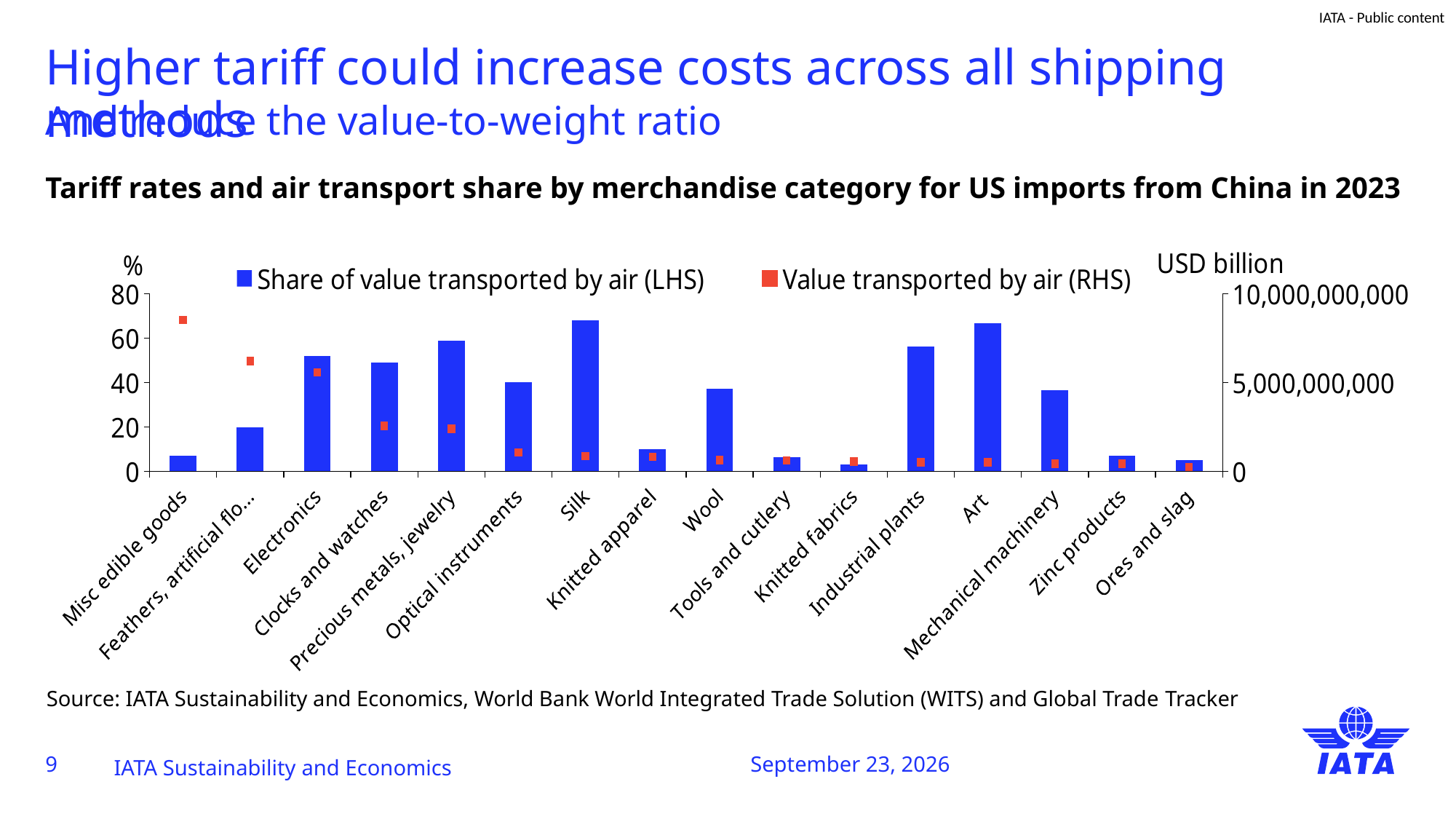
Is the value transported by air (red marker) for Misc edible goods greater or less than 5,000,000,000 on the right-hand axis? greater Which has a larger share of value transported by air, Art or Mechanical machinery? Art What kind of chart is shown on the slide? bar chart What unit is shown on the right-hand axis of the chart? USD billion Which has a larger share of value transported by air, Silk or Wool? Silk How many merchandise categories are shown on the x axis of the chart? 16 Which merchandise category has the lowest share of value transported by air (blue bar)? Knitted fabrics Is the share of value transported by air for Knitted apparel greater or less than 20%? less Is the share of value transported by air for Industrial plants greater or less than 40%? greater Which merchandise category has the highest value transported by air (red marker, RHS)? Misc edible goods How many series does the chart legend list? 2